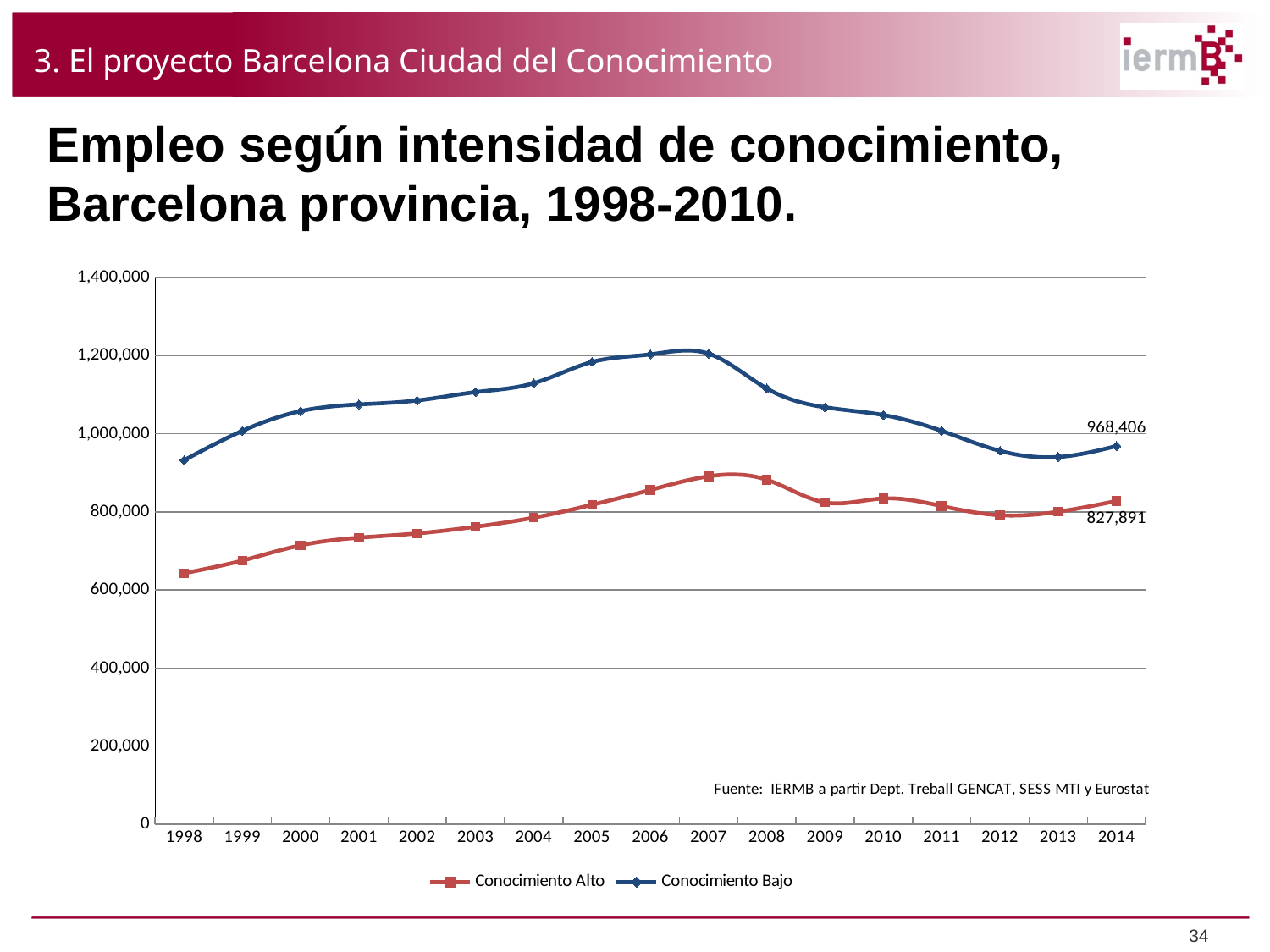
What is the difference between Conocimiento Bajo and Conocimiento Alto in 2014? 140,515 Is the value for Conocimiento Alto in 1998 greater or less than 800,000? less What is the value for Conocimiento Bajo in 2014? 968,406 How many years are shown on the x axis? 17 What kind of chart is shown on the slide? line chart How many series does the legend list? 2 Which year has the lowest value for Conocimiento Alto? 1998 In 2014, which series has the larger value, Conocimiento Alto or Conocimiento Bajo? Conocimiento Bajo Does the Conocimiento Alto series rise or fall from 1998 to 2007? rise Is the value for Conocimiento Bajo in 2005 greater or less than 1,000,000? greater What is the value for Conocimiento Alto in 2014? 827,891 Is the value for Conocimiento Bajo in 1998 greater or less than 1,000,000? less